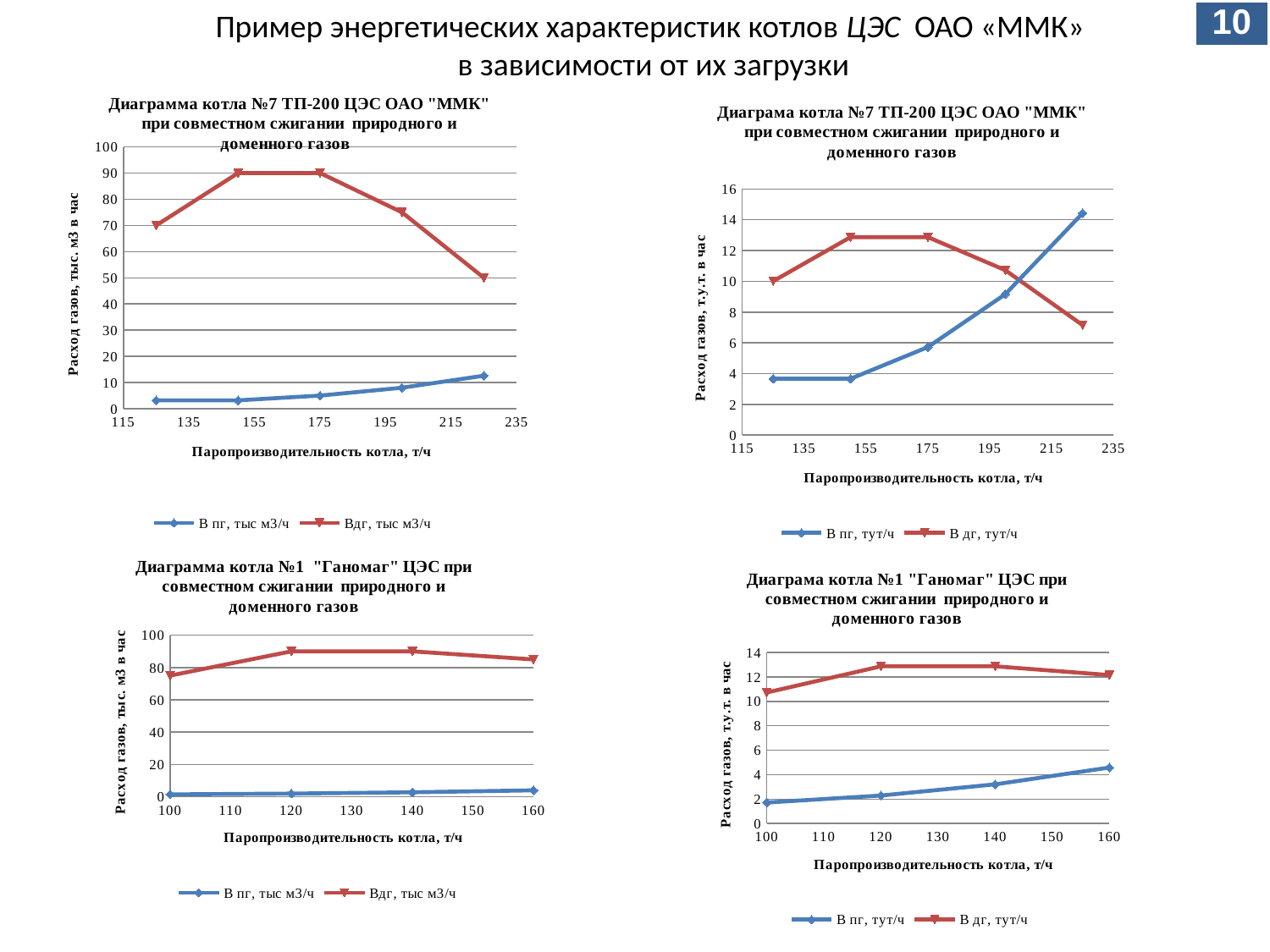
How many series does the legend of the top-left chart (котла №7, тыс. м3 в час) list? 2 In the top-right chart (котла №7, т.у.т. в час), which series has the larger value at 225 т/ч? В пг, тут/ч How many data points does each series have in the bottom-left chart (котла №1 "Ганомаг", тыс. м3 в час)? 4 In the top-left chart (котла №7, тыс. м3 в час), does the В пг, тыс м3/ч series rise or fall as паропроизводительность increases? rises In the bottom-left chart (котла №1 "Ганомаг", тыс. м3 в час), is the value of Вдг, тыс м3/ч at 100 т/ч greater or less than 60? greater In the top-right chart (котла №7, т.у.т. в час), is the value of В пг, тут/ч at 225 т/ч greater or less than 12? greater In the top-left chart (котла №7, тыс. м3 в час), is the value of Вдг, тыс м3/ч at 225 т/ч greater or less than 60? less How many data points does the Вдг, тыс м3/ч series have in the top-left chart (котла №7)? 5 What is the y-axis title of the bottom-right chart (котла №1 "Ганомаг", тут/ч)? Расход газов, т.у.т. в час In the top-right chart (котла №7, т.у.т. в час), at which паропроизводительность is the В пг, тут/ч series highest? 225 What type of chart is the top-left chart (Диаграмма котла №7 ТП-200, тыс. м3 в час)? Line chart